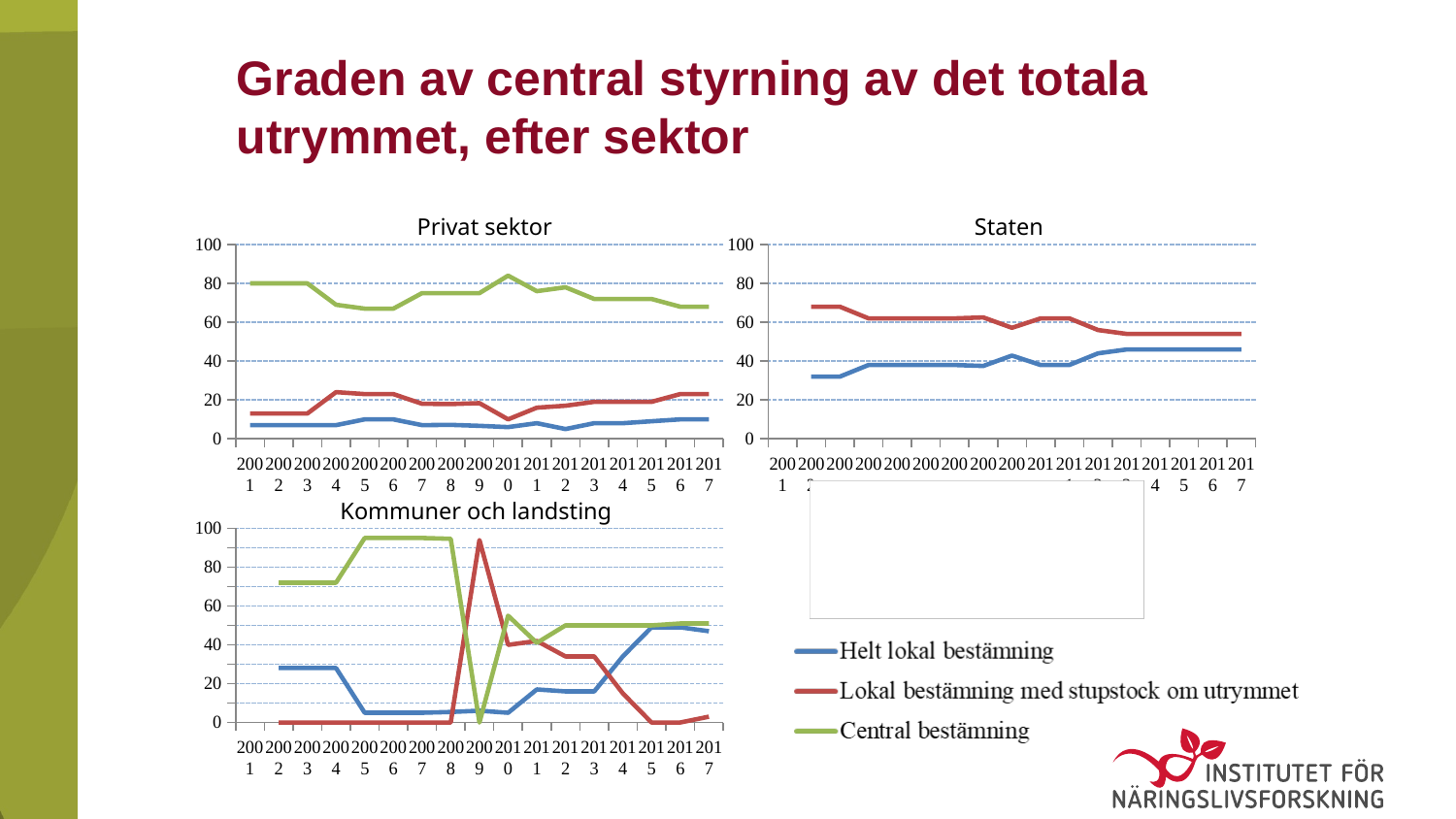
In the "Privat sektor" chart, is the value for Central bestämning in 2001 greater or less than 60? greater In the "Staten" chart, does the Helt lokal bestämning line rise or fall from 2001 to 2017? rise What colour is the line for Central bestämning in the charts? green In the "Privat sektor" chart, is the value for Helt lokal bestämning in 2017 greater or less than 20? less In the "Privat sektor" chart, which series has the lowest value in 2005? Helt lokal bestämning How many series does the legend list for the charts? 3 In the "Privat sektor" chart, how many years are plotted along the x axis? 17 In the "Kommuner och landsting" chart, is the value for Central bestämning in 2005 greater or less than 80? greater What kind of chart is the "Privat sektor" chart? line chart